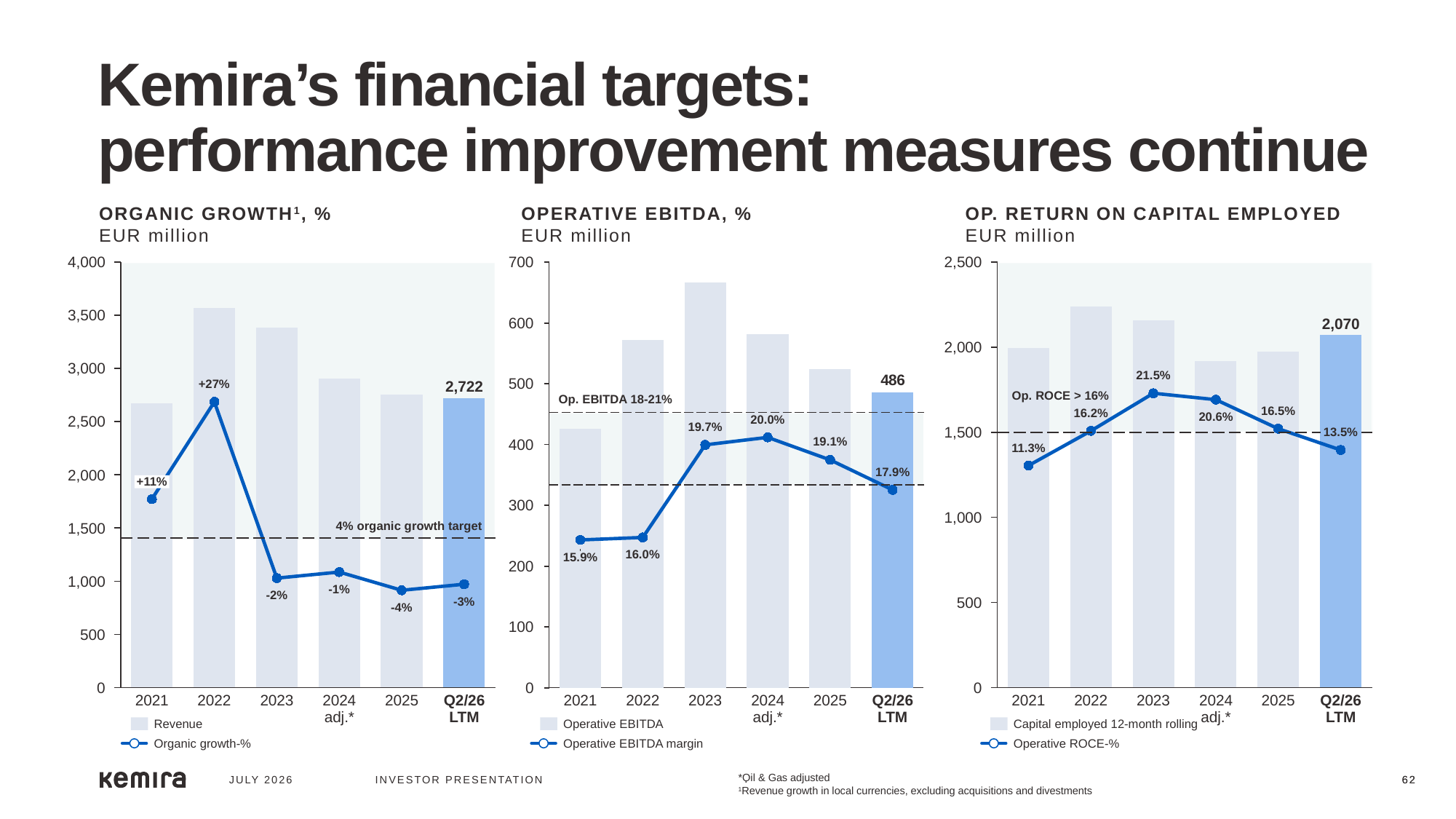
In the ORGANIC GROWTH chart, which period has the lowest organic growth-%? 2025 In the OP. RETURN ON CAPITAL EMPLOYED chart, what is the operative ROCE-% for 2023? 21.5% In the OPERATIVE EBITDA chart, which period has the highest operative EBITDA margin? 2024 adj.* How many series does the legend of the OPERATIVE EBITDA chart list? 2 In the OPERATIVE EBITDA chart, what is the difference in operative EBITDA margin between 2024 adj.* and 2021? 4.1 percentage points In the OPERATIVE EBITDA chart, what is the operative EBITDA value labelled for Q2/26 LTM? 486 In the OP. RETURN ON CAPITAL EMPLOYED chart, which period has the lowest operative ROCE-%? 2021 In the ORGANIC GROWTH chart, what is the organic growth-% for 2022? +27% In the OPERATIVE EBITDA chart, is the operative EBITDA bar for 2023 greater or less than 600? greater In the OP. RETURN ON CAPITAL EMPLOYED chart, does the operative ROCE-% rise or fall from 2023 to Q2/26 LTM? fall In the ORGANIC GROWTH chart, is the revenue bar for 2022 greater or less than 3,500? greater In the ORGANIC GROWTH chart, what is the revenue value labelled for Q2/26 LTM? 2,722